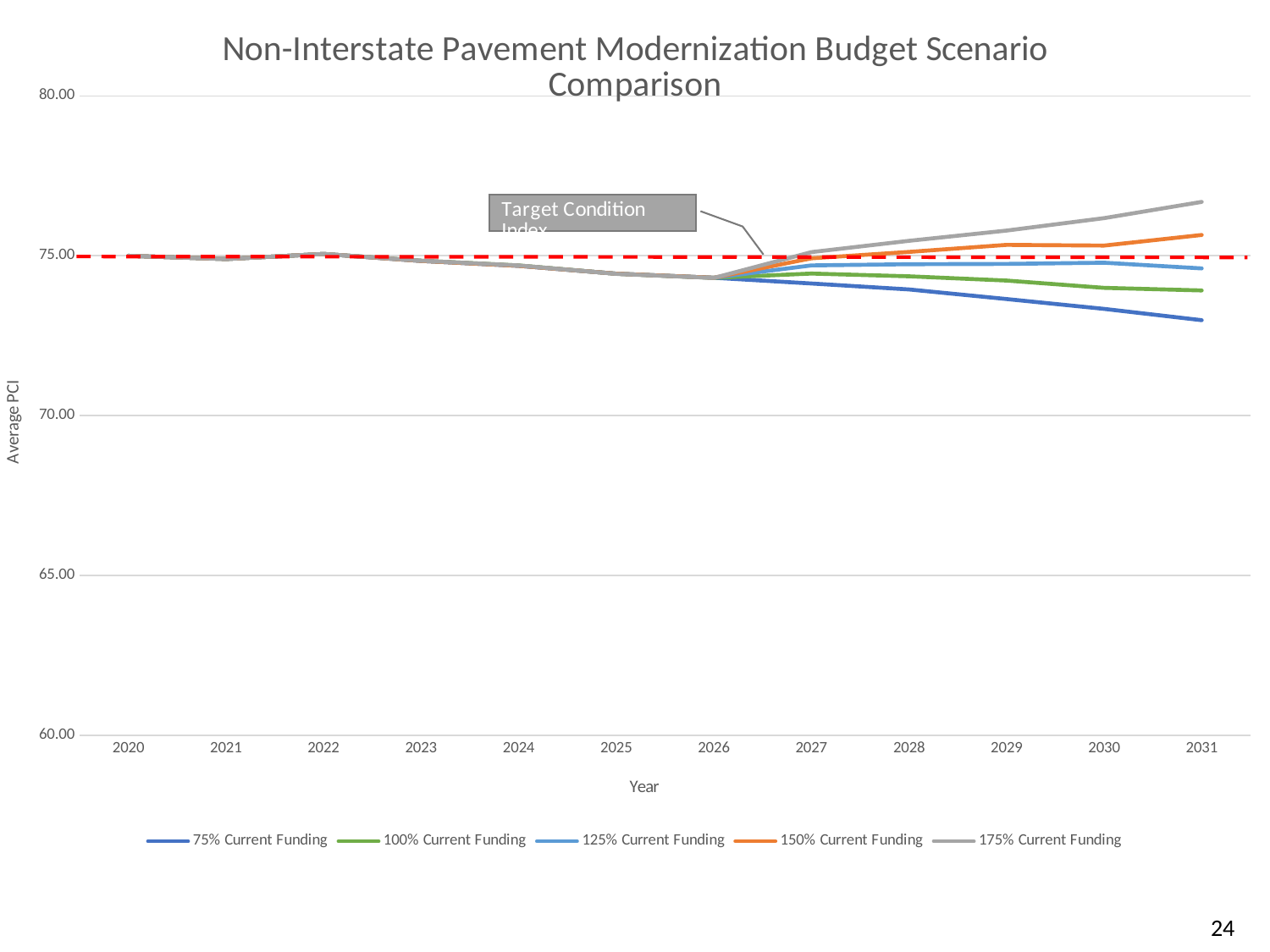
Does the Average PCI for 75% Current Funding rise or fall from 2026 to 2031? fall In 2031, which is higher: 150% Current Funding or 100% Current Funding? 150% Current Funding What does the red dashed horizontal line represent? Target Condition Index What kind of chart is shown on the slide? Line chart Is the Average PCI for 100% Current Funding in 2031 greater or less than 75.00? less How many series does the legend list? 5 How many years are shown along the x axis? 12 Does the Average PCI for 175% Current Funding rise or fall from 2026 to 2031? rise Which funding scenario has the lowest Average PCI in 2031? 75% Current Funding Which funding scenario has the highest Average PCI in 2031? 175% Current Funding Is the Average PCI for 175% Current Funding in 2031 greater or less than 75.00? greater Is the Average PCI for 75% Current Funding in 2031 greater or less than 75.00? less